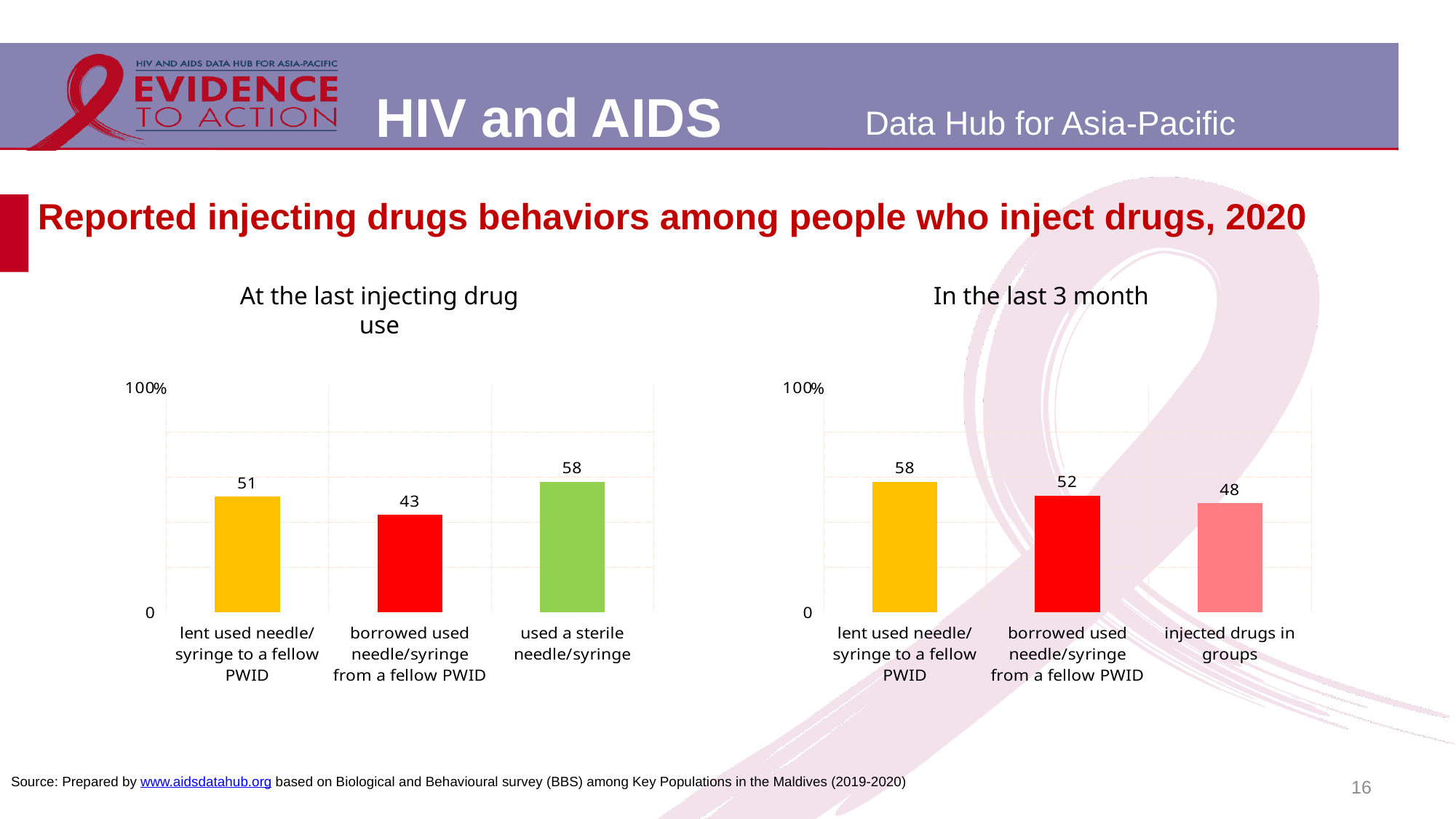
In the 'At the last injecting drug use' chart, what is the value for 'lent used needle/syringe to a fellow PWID'? 51 In the 'In the last 3 month' chart, what is the value for 'injected drugs in groups'? 48 In the 'At the last injecting drug use' chart, what is the value for 'borrowed used needle/syringe from a fellow PWID'? 43 In the 'At the last injecting drug use' chart, which category has the lowest value? borrowed used needle/syringe from a fellow PWID In the 'At the last injecting drug use' chart, which category has the highest value? used a sterile needle/syringe Which is larger: 'lent used needle/syringe to a fellow PWID' in the 'At the last injecting drug use' chart or in the 'In the last 3 month' chart? In the last 3 month In the 'In the last 3 month' chart, what is the value for 'borrowed used needle/syringe from a fellow PWID'? 52 What type of chart is the 'At the last injecting drug use' chart? bar chart In the 'In the last 3 month' chart, what is the difference between 'lent used needle/syringe to a fellow PWID' and 'injected drugs in groups'? 10 How many categories are shown in the 'In the last 3 month' chart? 3 In the 'In the last 3 month' chart, which category has the highest value? lent used needle/syringe to a fellow PWID In the 'At the last injecting drug use' chart, what is the difference between 'used a sterile needle/syringe' and 'borrowed used needle/syringe from a fellow PWID'? 15